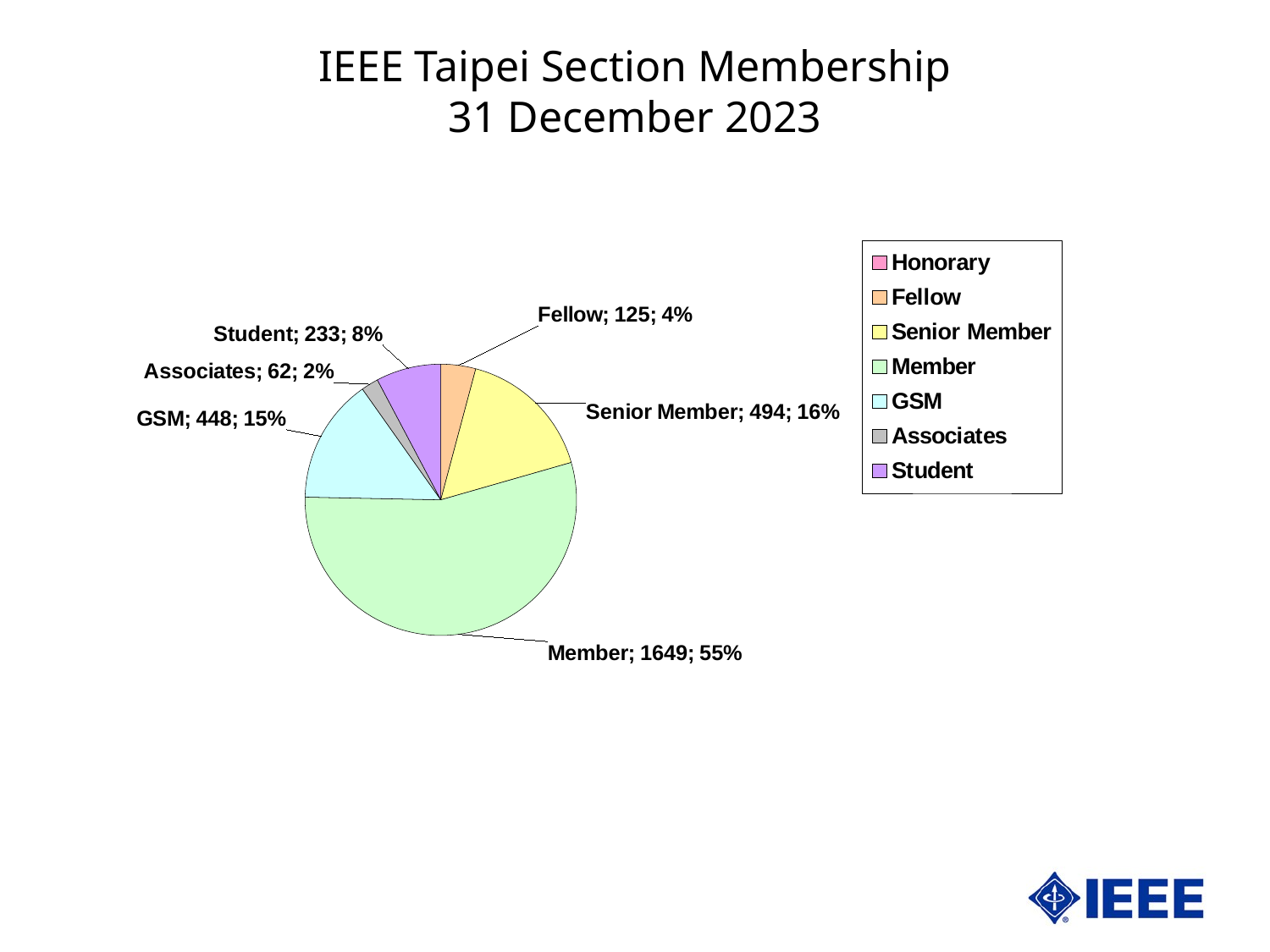
What percentage share of the pie does the Member slice represent? 55% How many entries does the legend list? 7 Which category has the largest slice of the pie? Member What type of chart is shown on the slide? pie chart How many members are in the Member category? 1649 What is the value shown for Associates? 62 What is the difference between the Senior Member value and the GSM value? 46 Which is larger, the Student value or the Fellow value? Student What percentage share of the pie does the Student slice represent? 8% Which labeled category has the smallest slice of the pie? Associates What is the value shown for Senior Member? 494 What is the value shown for GSM? 448